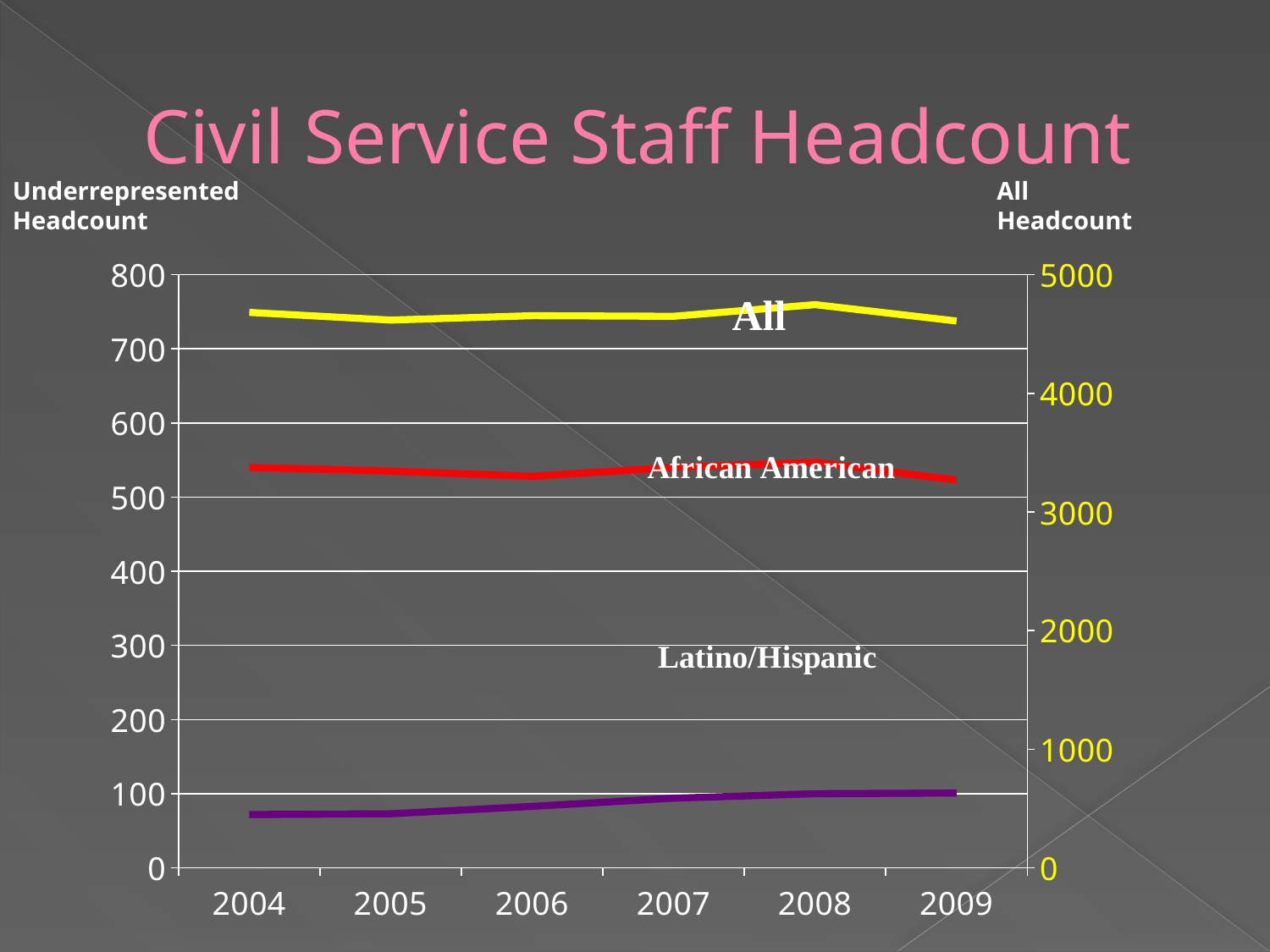
Is the Latino/Hispanic value for 2004 greater or less than 100? less Is the African American value for 2004 greater or less than 500? greater In which year does the All line reach its highest point? 2008 What kind of chart is shown on the slide? line chart Does the Latino/Hispanic line rise or fall from 2004 to 2009? rise How many years are shown along the x axis? 6 How many series are plotted on the chart? 3 Which series has the lowest values across all years? Latino/Hispanic What is the label of the right-hand vertical axis? All Headcount In 2009, which is larger, the African American value or the Latino/Hispanic value? African American Is the All value for 2004 greater or less than 4000 on the right axis? greater What is the title of the chart? Civil Service Staff Headcount